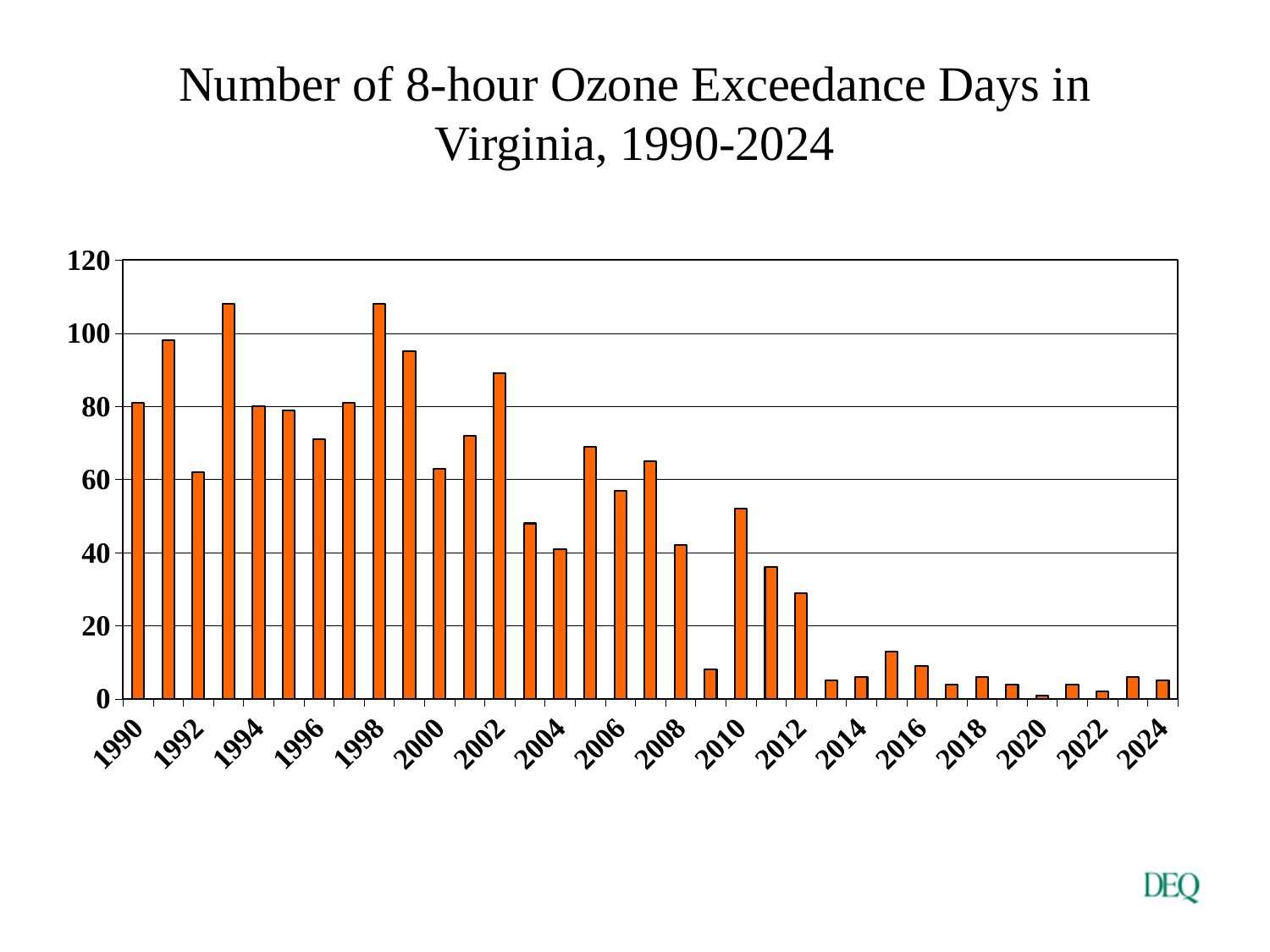
Is the value for 1998 greater or less than 100? greater Which year has the lowest number of exceedance days? 2020 Which year has more exceedance days, 2010 or 2011? 2010 Is the value for 2009 greater or less than 20? less Overall, do the values rise or fall from 1990 to 2024? fall Which year has more exceedance days, 1991 or 1992? 1991 Is the value for 2011 greater or less than 40? less What kind of chart is shown on the slide? bar chart How many years (bars) are plotted in the chart? 35 What is the title of the chart? Number of 8-hour Ozone Exceedance Days in Virginia, 1990-2024